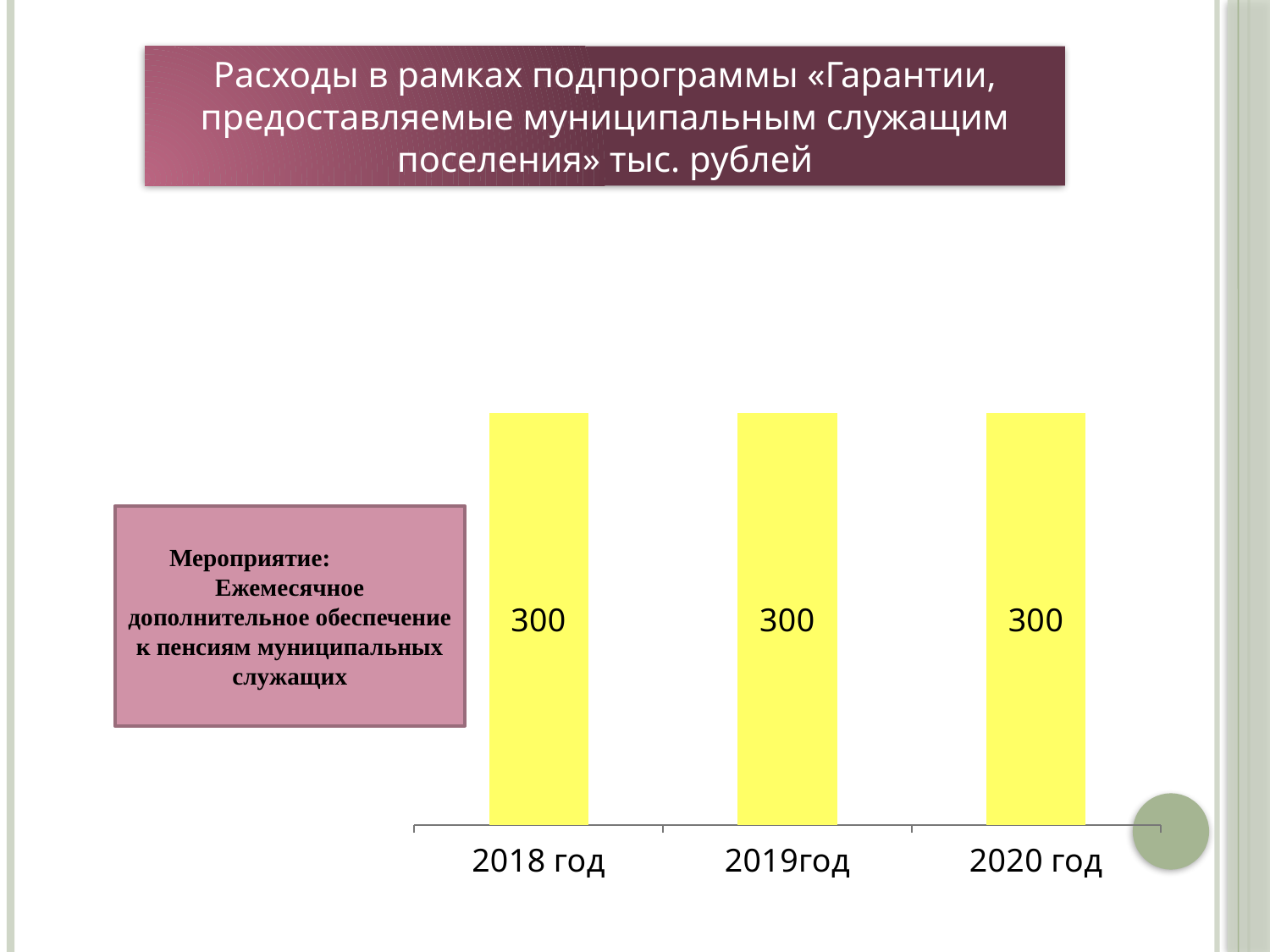
What colour are the bars in the chart? yellow What is the difference between the values for 2018 год and 2020 год? 0 In what units are the values in the chart expressed, according to the slide title? тыс. рублей What is the value for 2018 год? 300 What kind of chart is shown on the slide? bar chart Do the values rise, fall or stay the same from 2018 год to 2020 год? stay the same What is the value for 2019год? 300 What is the value for 2020 год? 300 How many categories are shown on the x axis? 3 What is the total of the values for 2018 год, 2019год and 2020 год? 900